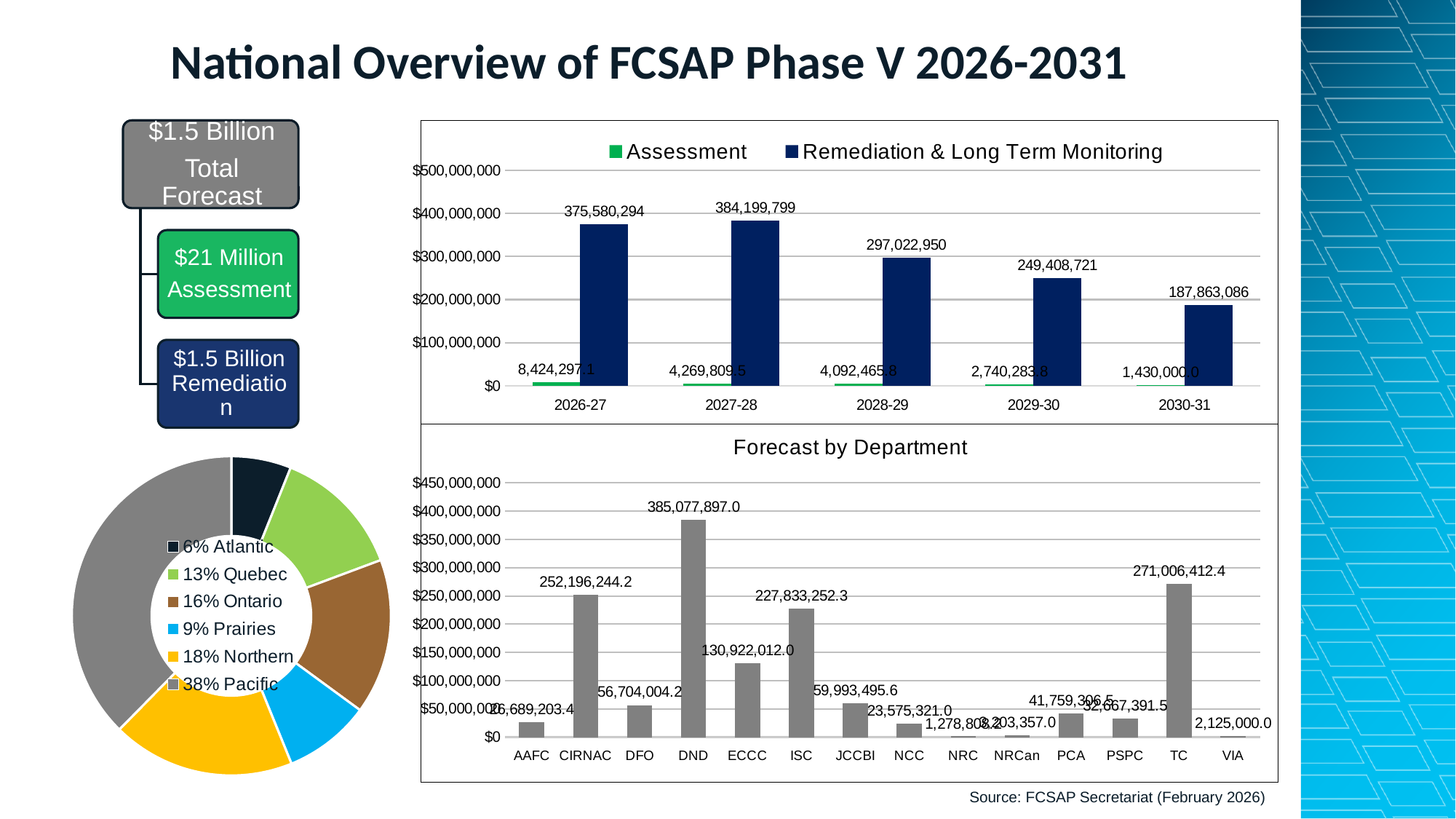
In the Forecast by Department chart, which department has the highest forecast? DND In the top bar chart, which fiscal year has the highest Remediation & Long Term Monitoring value? 2027-28 In the donut chart on the left, what share does Northern have? 18% How many departments are shown in the Forecast by Department chart? 14 In the top bar chart, what is the Remediation & Long Term Monitoring value for 2027-28? 384,199,799 In the Forecast by Department chart, what is the value for TC? 271,006,412.4 In the top bar chart, what is the difference between the Remediation & Long Term Monitoring values for 2026-27 and 2030-31? 187,717,208 In the Forecast by Department chart, which is larger, the value for CIRNAC or the value for ISC? CIRNAC In the top bar chart, do the Remediation & Long Term Monitoring values rise or fall from 2027-28 to 2030-31? fall In the donut chart on the left, which region has the largest share? Pacific In the top bar chart, which fiscal year has the lowest Remediation & Long Term Monitoring value? 2030-31 How many series does the legend of the top bar chart list? 2